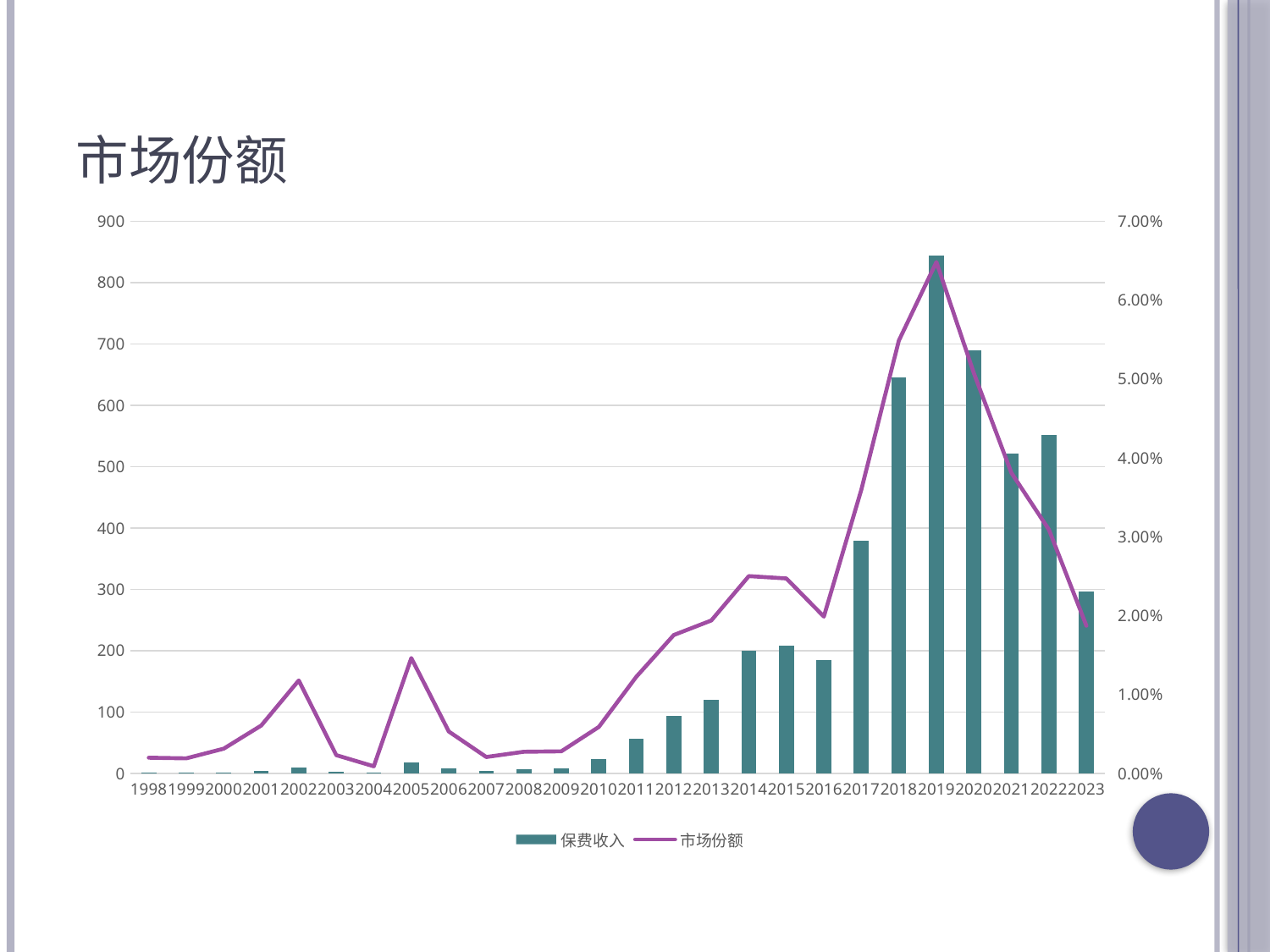
Is the 市场份额 value for 2018 greater or less than 5.00%? greater In which year does the 市场份额 line reach its highest point? 2019 Do the 保费收入 bars rise or fall from 2019 to 2023? Fall What kind of chart is shown on the slide? A combined bar and line chart How many series does the legend list? 2 What is the title of the chart? 市场份额 In which year is the 保费收入 bar the highest? 2019 Is the 市场份额 value for 2023 greater or less than 2.00%? less Is the 保费收入 value for 2019 greater or less than 800? greater Which year has the larger 保费收入 bar, 2017 or 2022? 2022 How many years are shown on the x axis? 26